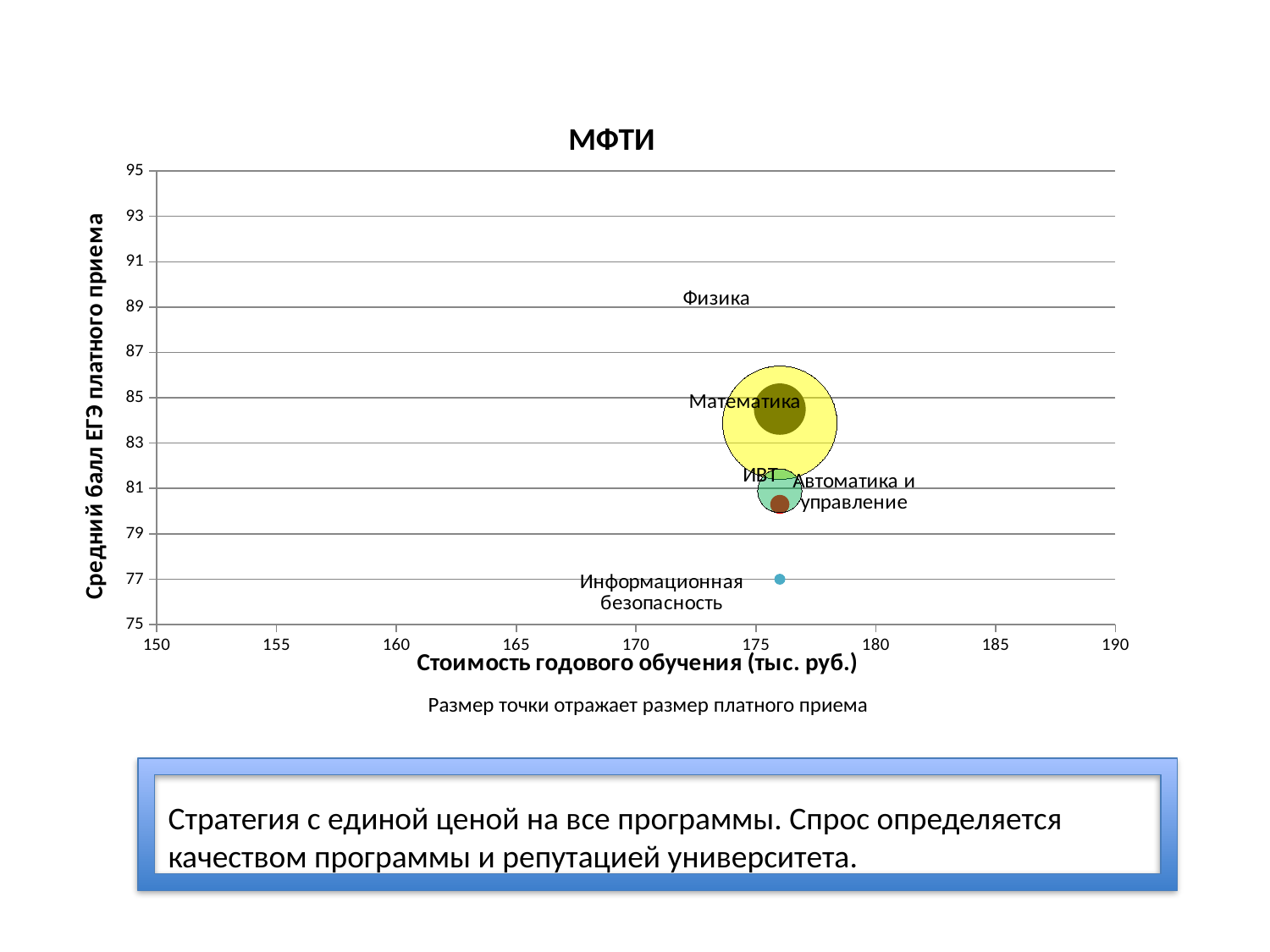
Is the average ЕГЭ score for Информационная безопасность greater or less than 80? less Which program has the lowest average ЕГЭ score on the chart? Информационная безопасность How many programs are labelled on the chart? 5 Which has the higher average ЕГЭ score, Автоматика и управление or Информационная безопасность? Автоматика и управление Is the average ЕГЭ score for ИВТ greater or less than 85? less Which has the higher average ЕГЭ score, Математика or Информационная безопасность? Математика What is the title of the chart? МФТИ What is the maximum value shown on the y axis? 95 Is the annual tuition cost for Информационная безопасность greater or less than 170? greater What kind of chart is shown on the slide? Bubble chart What does the x axis of the chart represent? Стоимость годового обучения (тыс. руб.)